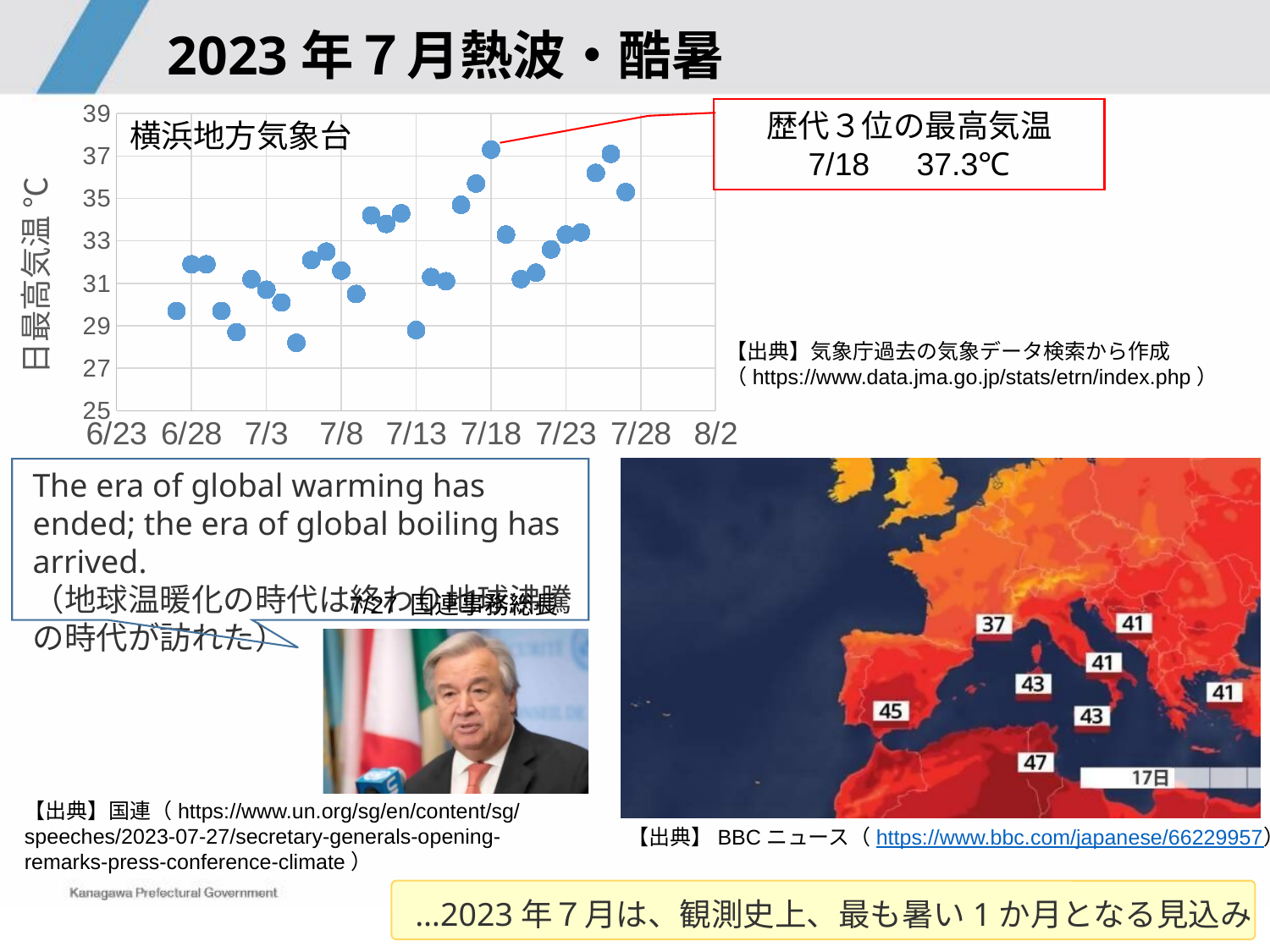
Is the value for 7/18 greater or less than 37? greater What is the highest value shown on the y axis of the chart? 39 Is the value for 7/18 greater or less than 35? greater What is the daily maximum temperature recorded on 7/18 in the chart? 37.3℃ What is the lowest value shown on the y axis of the chart? 25 What kind of chart is shown on the slide? scatter chart What is the label on the y axis of the chart? 日最高気温 ℃ Which observation station is named in the chart? 横浜地方気象台 Do the plotted values generally rise or fall from late June to late July? rise On which date does the chart show the highest daily maximum temperature? 7/18 How many date labels are shown on the x axis of the chart? 9